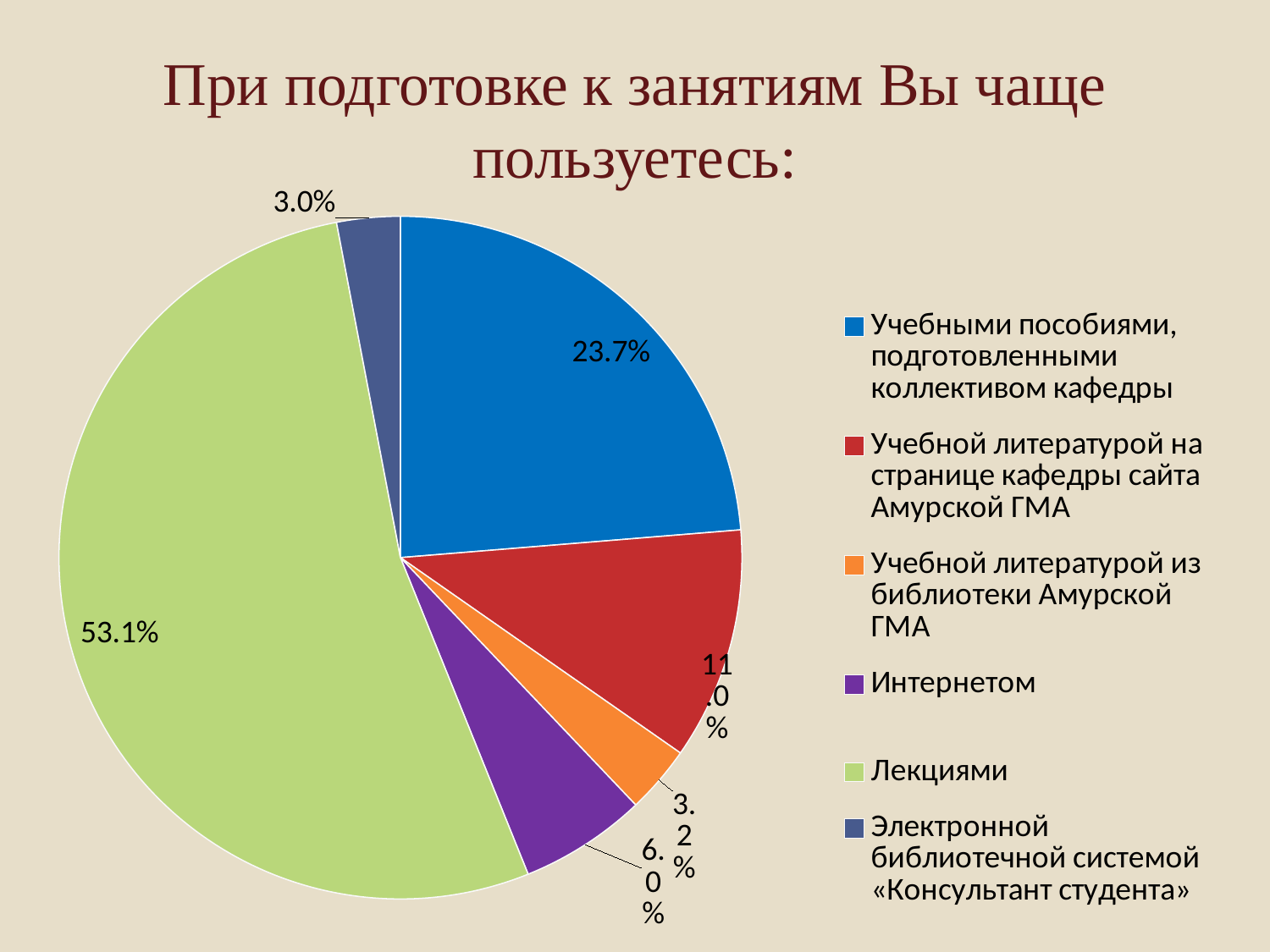
How many categories does the legend list? 6 What percentage is shown for «Учебными пособиями, подготовленными коллективом кафедры»? 23.7% Which category has the largest slice of the pie? Лекциями What percentage is shown for «Интернетом»? 6.0% What percentage is shown for «Электронной библиотечной системой «Консультант студента»»? 3.0% What is the difference in percentage points between «Лекциями» and «Учебными пособиями, подготовленными коллективом кафедры»? 29.4 Which category has the smallest slice of the pie? Электронной библиотечной системой «Консультант студента» What percentage is shown for «Учебной литературой на странице кафедры сайта Амурской ГМА»? 11.0% What kind of chart is shown on the slide? Pie chart What colour is the slice for «Лекциями»? Light green Which is larger: the slice for «Интернетом» or the slice for «Учебной литературой из библиотеки Амурской ГМА»? Интернетом What percentage of the pie is labelled for «Лекциями»? 53.1%